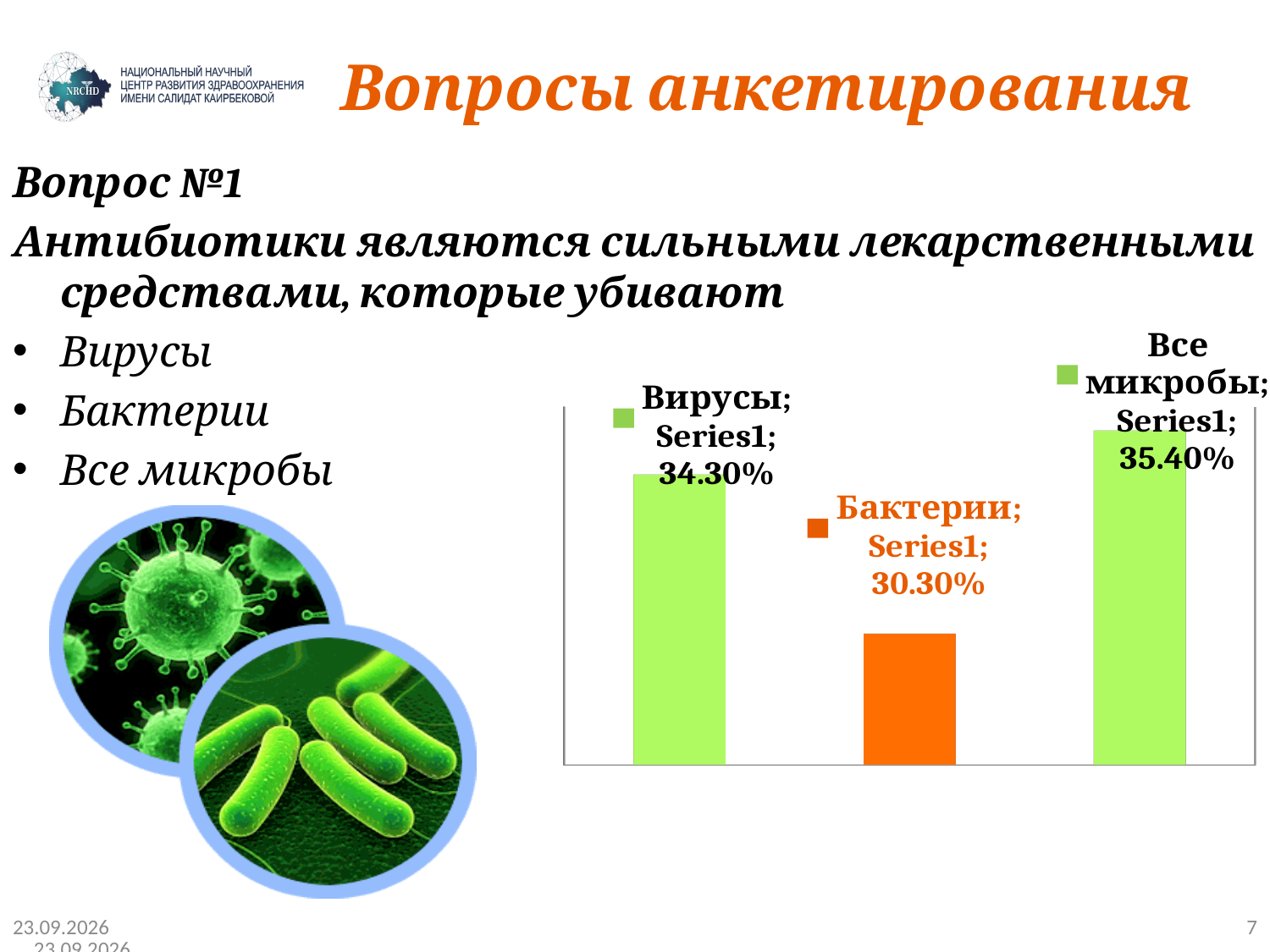
What is the difference between the values for Все микробы and Бактерии? 5.10% How many categories are shown in the chart? 3 What is the value for Бактерии in the chart? 30.30% Which category has the lowest value in the chart? Бактерии What is the value for Вирусы in the chart? 34.30% What is the value for Все микробы in the chart? 35.40% What is the difference between the values for Вирусы and Бактерии? 4.00% Which is larger, the value for Вирусы or the value for Бактерии? Вирусы What kind of chart is shown on the slide? Bar chart What is the difference between the values for Все микробы and Вирусы? 1.10% Which category has the highest value in the chart? Все микробы Which category's bar is coloured orange in the chart? Бактерии